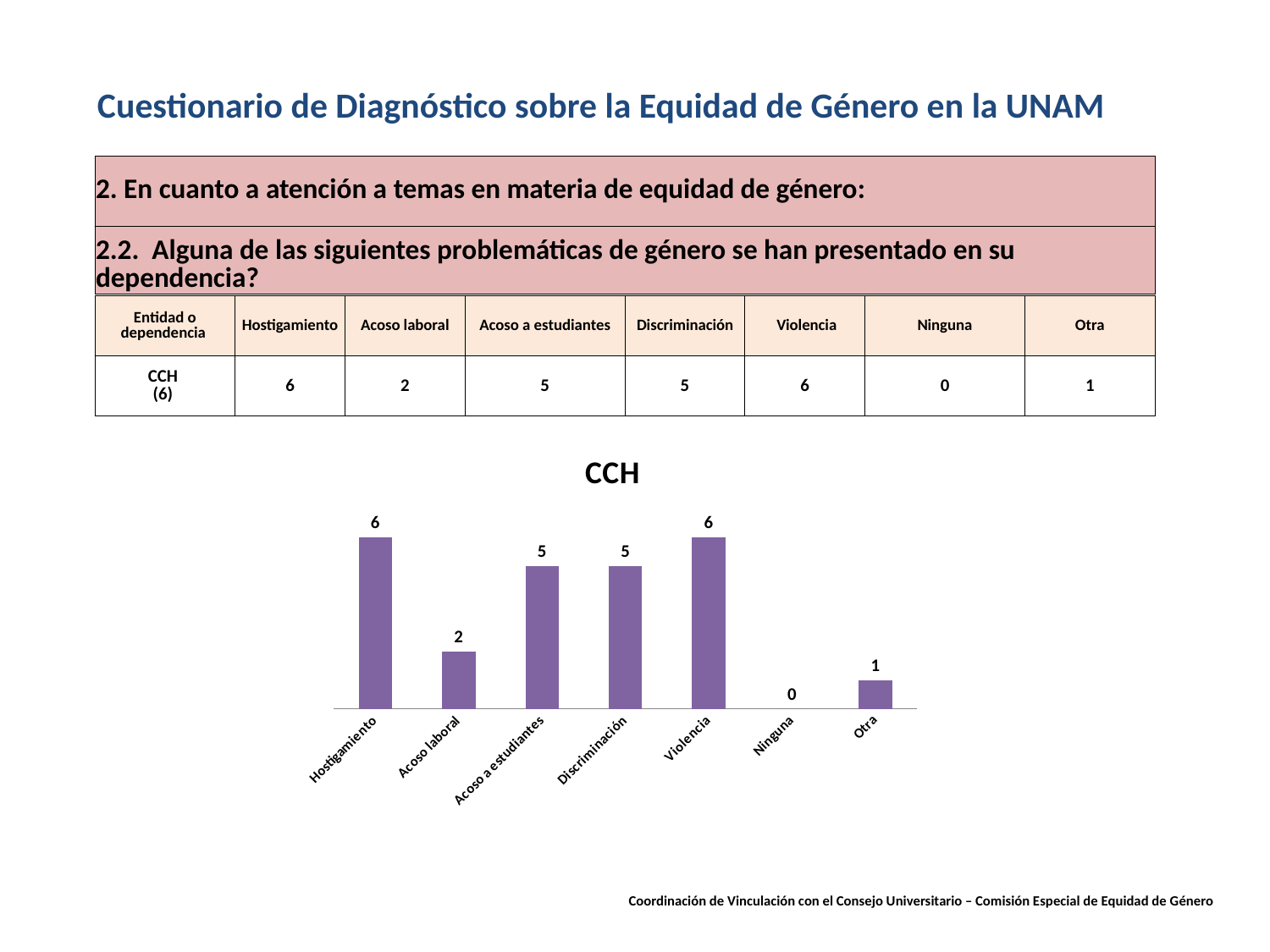
What kind of chart is shown on the slide? Bar chart What is the value for Discriminación in the CCH chart? 5 What is the value for Ninguna in the CCH chart? 0 What is the value for Otra in the CCH chart? 1 Which category has the lowest value in the CCH chart? Ninguna What is the difference between the values for Acoso a estudiantes and Otra in the CCH chart? 4 What is the value for Acoso laboral in the CCH chart? 2 How many categories are shown in the CCH chart? 7 What is the title of the chart on the slide? CCH Which is larger in the CCH chart, Acoso laboral or Otra? Acoso laboral What is the difference between the values for Hostigamiento and Acoso laboral in the CCH chart? 4 Which is larger in the CCH chart, Violencia or Discriminación? Violencia